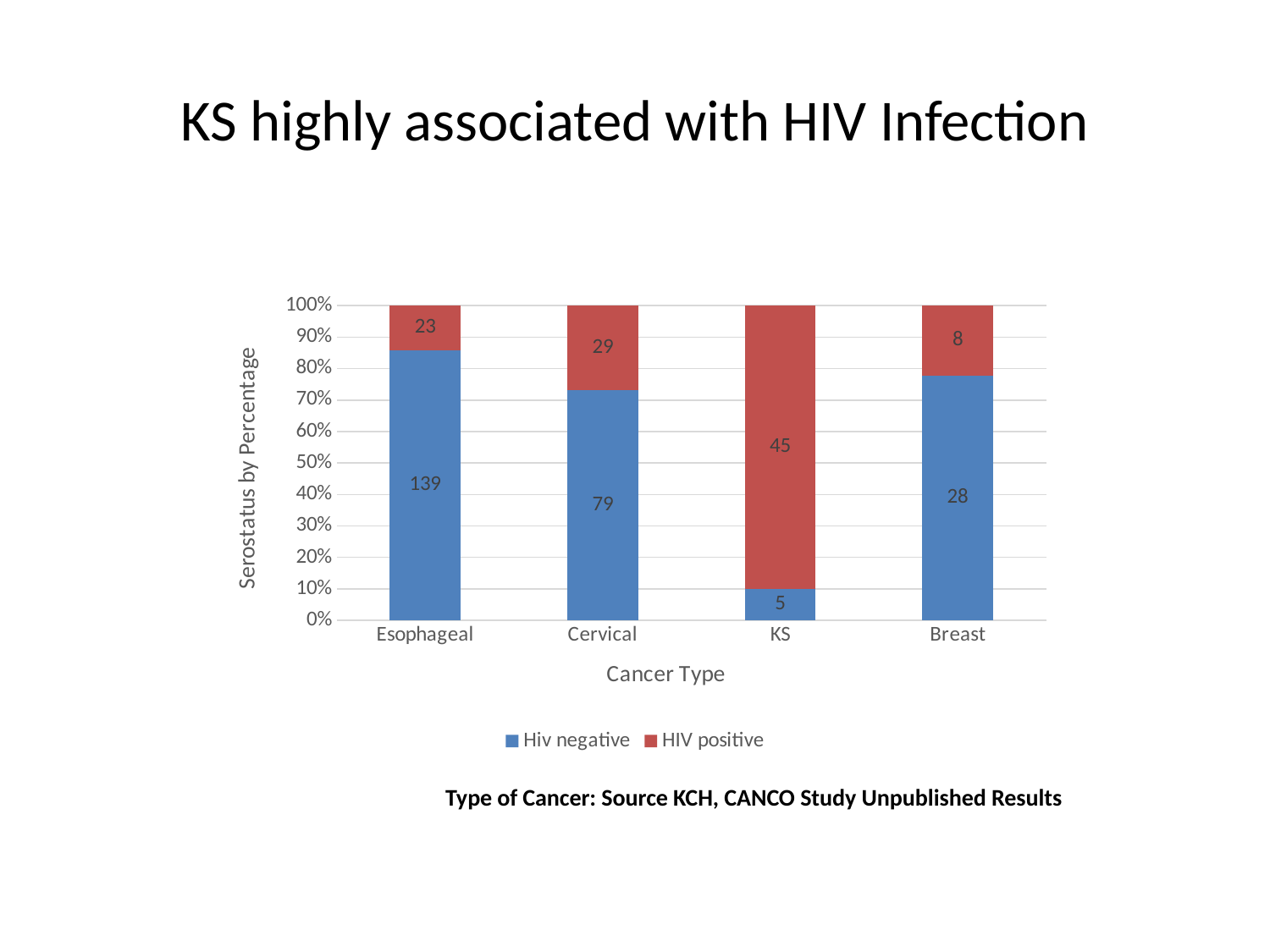
What is the total number of cases in the KS bar? 50 What is the difference between the Hiv negative counts for Esophageal and Cervical cancer? 60 Which is larger, the HIV positive count for Cervical cancer or for Esophageal cancer? Cervical How many cancer types are shown on the x axis? 4 What is the Hiv negative value for Breast cancer? 28 Which cancer type has the lowest Hiv negative count? KS How many HIV negative cases are shown for Esophageal cancer? 139 What is the HIV positive count for KS? 45 Which cancer type has the highest HIV positive count? KS What kind of chart is shown on the slide? Stacked bar chart Is the Hiv negative share of the Esophageal bar greater or less than 80%? greater How many series does the legend list? 2